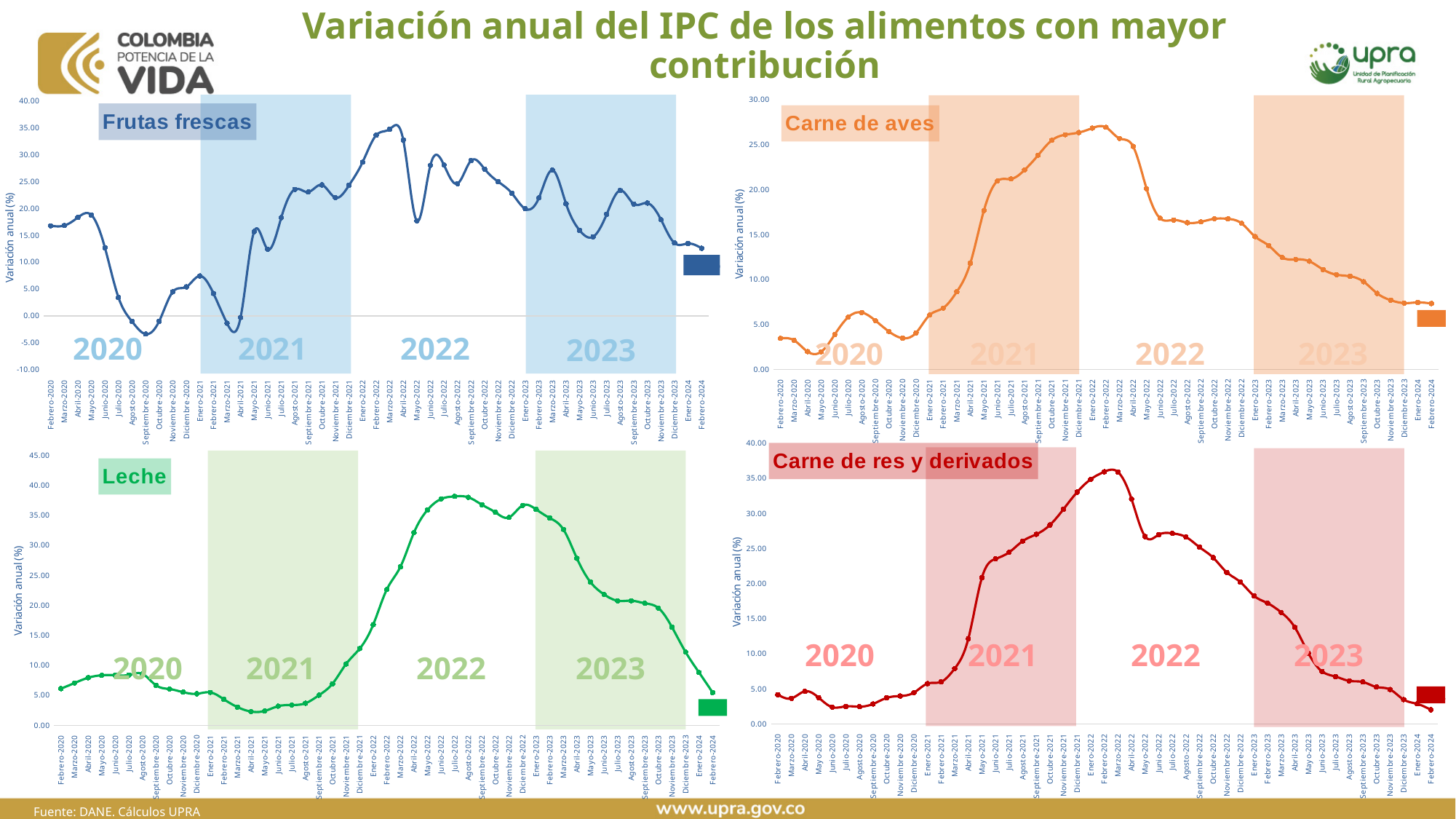
In the 'Frutas frescas' chart, is the value for Abril-2022 greater or less than 30? greater In the 'Carne de aves' chart, is the value for Febrero-2024 greater or less than 5? greater What is the label on the vertical axis of the 'Leche' chart? Variación anual (%) In the 'Leche' chart, do the values rise or fall from Abril-2021 to Julio-2022? rise In the 'Carne de res y derivados' chart, which is larger, the value for Marzo-2022 or the value for Febrero-2020? Marzo-2022 In the 'Frutas frescas' chart, is the value for Septiembre-2020 greater or less than 0? less In the 'Carne de aves' chart, do the values rise or fall from Febrero-2022 to Febrero-2024? fall What kind of chart is the 'Frutas frescas' chart? line chart How many charts are shown on the slide? 4